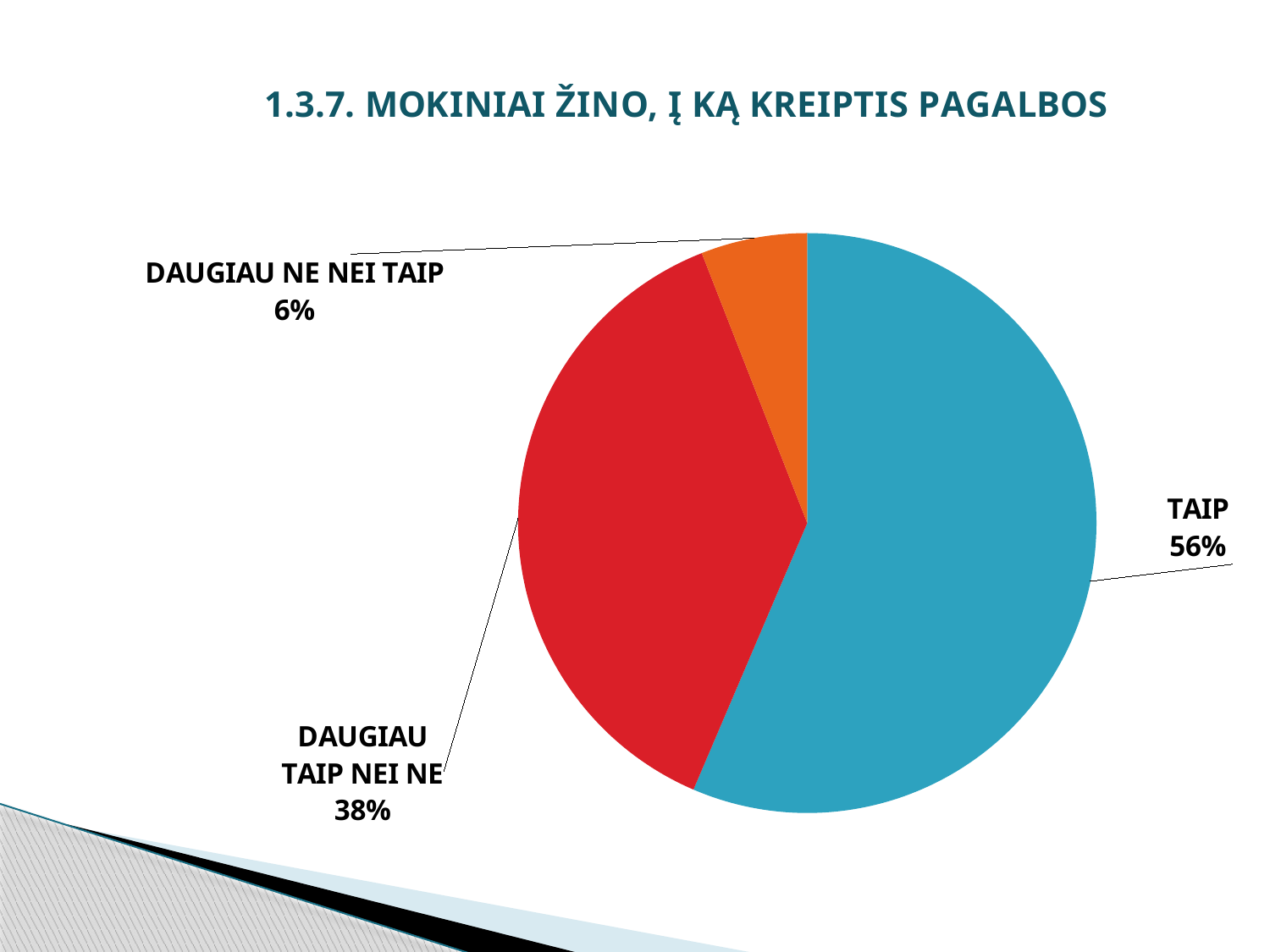
Which category has the largest slice of the pie? TAIP What is the difference in percentage points between TAIP and DAUGIAU TAIP NEI NE? 18 What share of the pie does DAUGIAU TAIP NEI NE have? 38% Which is larger, the slice for TAIP or the slice for DAUGIAU TAIP NEI NE? TAIP How many slices does the pie chart have? 3 What share of the pie does TAIP have? 56% What kind of chart is shown on the slide? pie chart What is the difference in percentage points between DAUGIAU TAIP NEI NE and DAUGIAU NE NEI TAIP? 32 What share of the pie does DAUGIAU NE NEI TAIP have? 6% Which category has the smallest slice of the pie? DAUGIAU NE NEI TAIP What is the title of the chart? 1.3.7. MOKINIAI ŽINO, Į KĄ KREIPTIS PAGALBOS What colour is the slice for DAUGIAU TAIP NEI NE? red